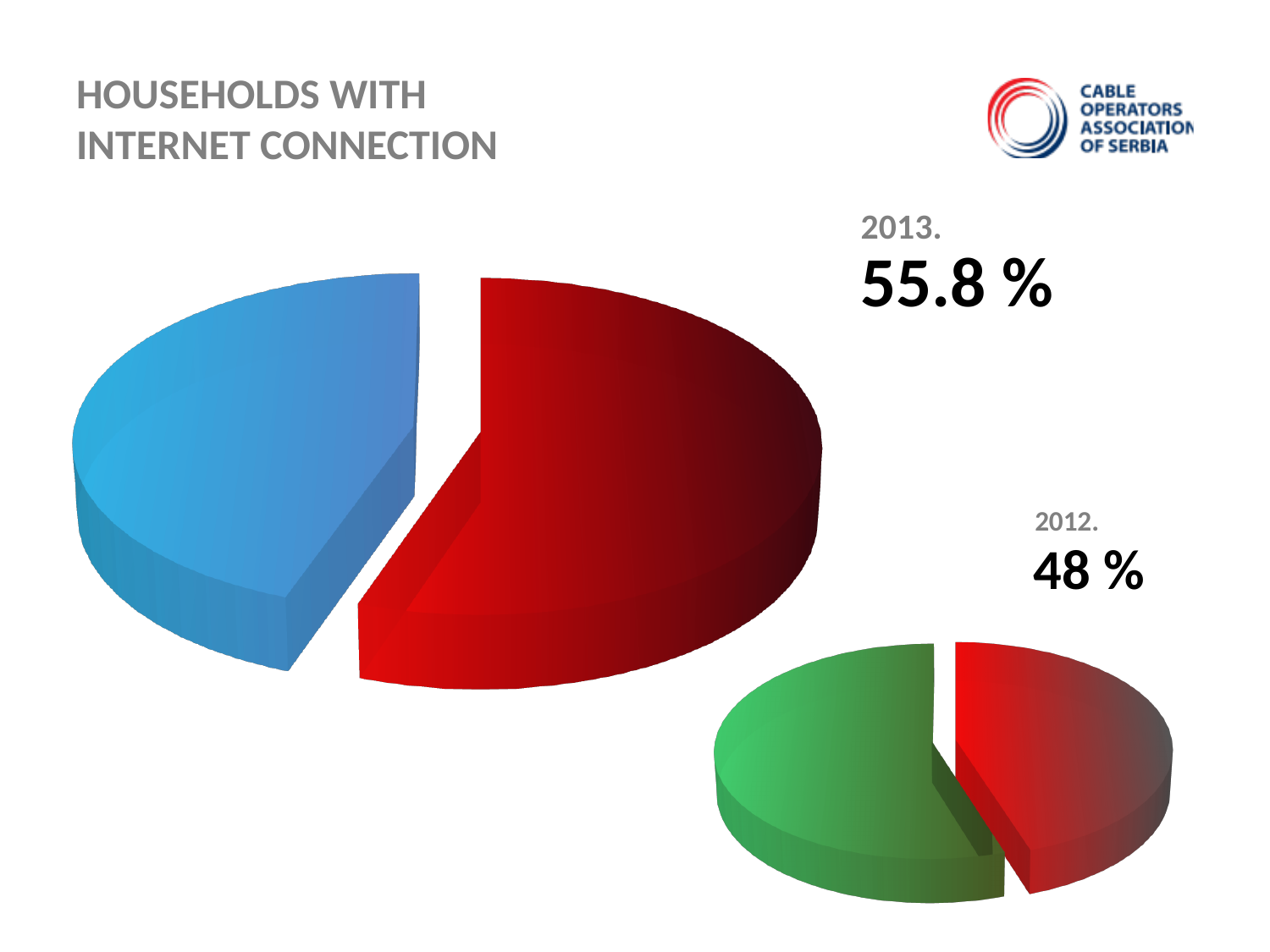
What percentage of households had an internet connection in 2013 according to the slide? 55.8 % Is the 2013 value for households with an internet connection greater or less than 50 %? greater Is the 2012 value for households with an internet connection greater or less than 50 %? less Did the share of households with an internet connection rise or fall from 2012 to 2013? rise What percentage of households had an internet connection in 2012 according to the slide? 48 % What is the title of the slide containing the pie charts? HOUSEHOLDS WITH INTERNET CONNECTION How many slices does the large pie chart for 2013 have? 2 In the large 2013 pie chart, which slice is larger, the red one or the blue one? red How many pie charts are shown on the slide? 2 What kind of chart is used on this slide to show the household internet connection data? pie chart By how many percentage points did the share of households with an internet connection change from 2012 to 2013? 7.8 % Which year shows the higher share of households with an internet connection, 2012 or 2013? 2013